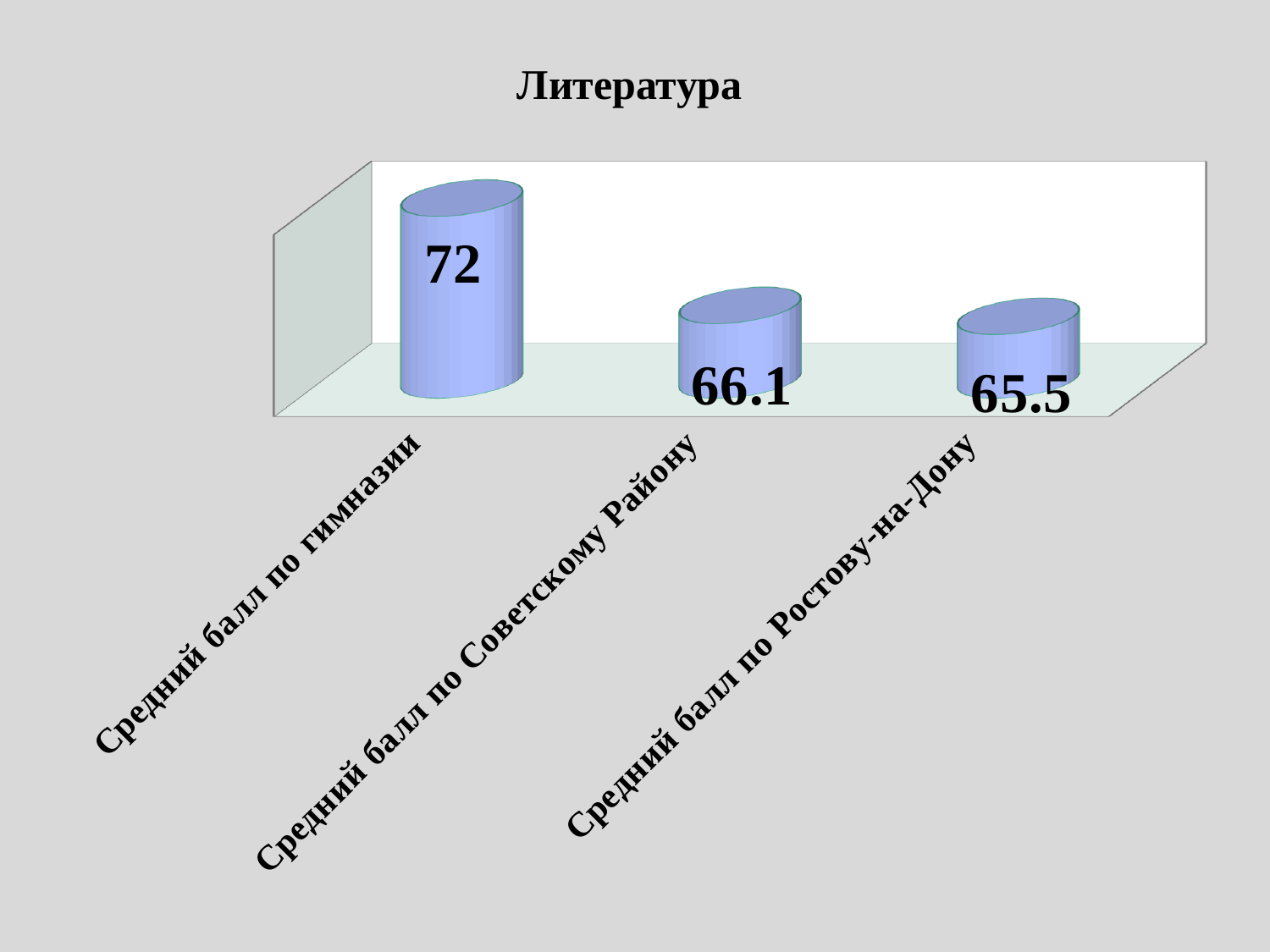
What is the average score for Rostov-on-Don (Средний балл по Ростову-на-Дону)? 65.5 Which is larger: the average score for the gymnasium or for Rostov-on-Don? Средний балл по гимназии What is the average score for Sovetsky District (Средний балл по Советскому Району)? 66.1 What is the title of the chart? Литература What is the difference between the gymnasium's average score and the Rostov-on-Don average score? 6.5 What is the average score for the gymnasium (Средний балл по гимназии)? 72 How many categories are shown in the chart? 3 Which category has the lowest average score? Средний балл по Ростову-на-Дону Which category has the highest average score? Средний балл по гимназии What is the difference between the gymnasium's average score and the Sovetsky District average score? 5.9 What is the difference between the Sovetsky District average score and the Rostov-on-Don average score? 0.6 What kind of chart is shown on the slide? Bar chart